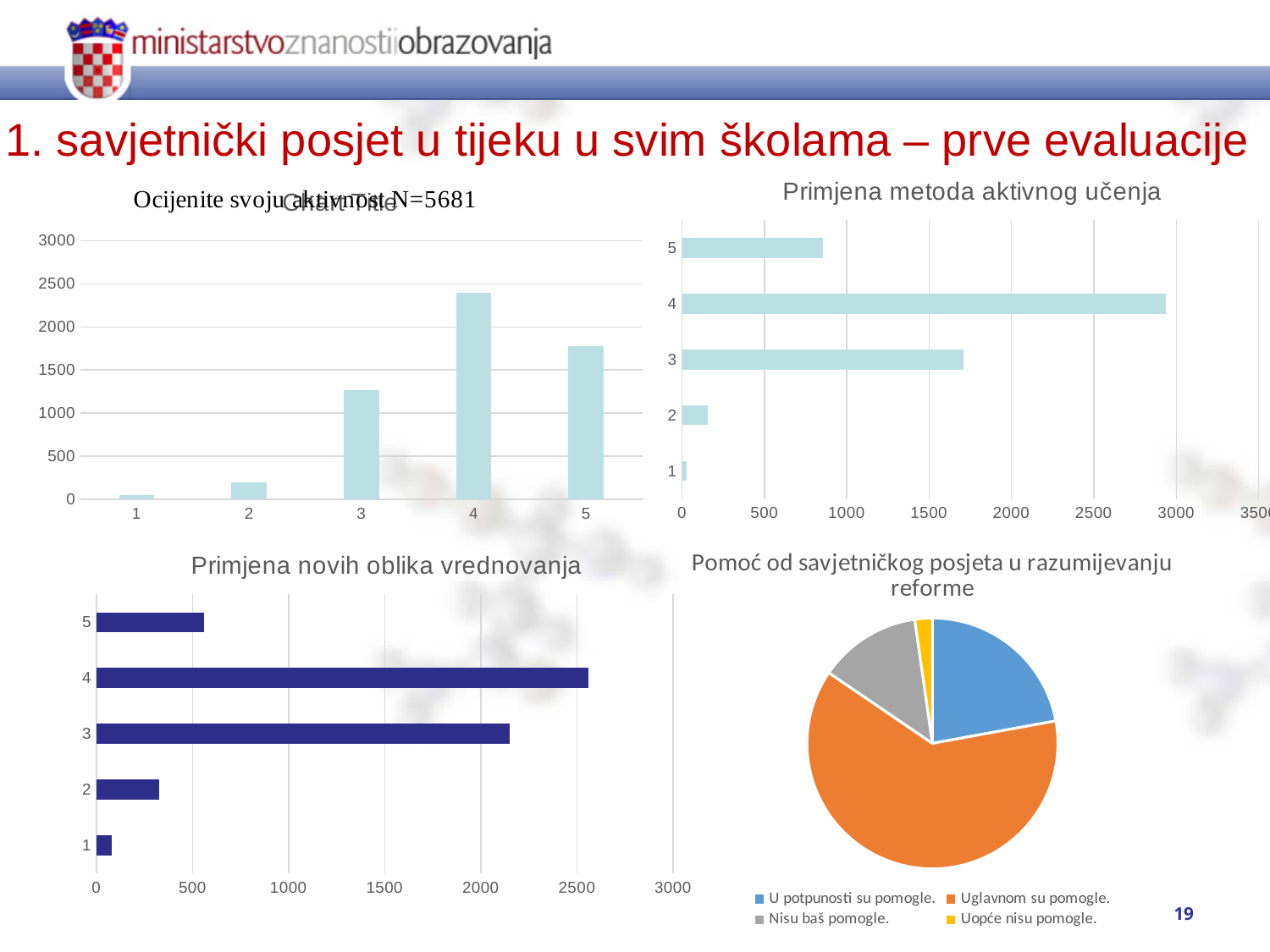
In the chart 'Primjena metoda aktivnog učenja', which category has the highest value? 4 In the chart 'Primjena novih oblika vrednovanja', is the value for category 3 greater or less than 2000? greater In the top-left chart 'Ocijenite svoju aktivnost N=5681', which category has the lowest value? 1 In the top-left chart 'Ocijenite svoju aktivnost N=5681', is the value for category 4 greater or less than 2000? greater In the top-left chart 'Ocijenite svoju aktivnost N=5681', which category has the highest value? 4 In the chart 'Primjena novih oblika vrednovanja', which category has the lowest value? 1 In the chart 'Primjena metoda aktivnog učenja', is the value for category 3 greater or less than 1500? greater In the chart 'Primjena metoda aktivnog učenja', which is larger, the value for category 5 or the value for category 2? 5 What kind of chart is 'Primjena novih oblika vrednovanja'? bar chart In the pie chart 'Pomoć od savjetničkog posjeta u razumijevanju reforme', which category has the largest slice? Uglavnom su pomogle. How many entries does the legend of the pie chart 'Pomoć od savjetničkog posjeta u razumijevanju reforme' list? 4